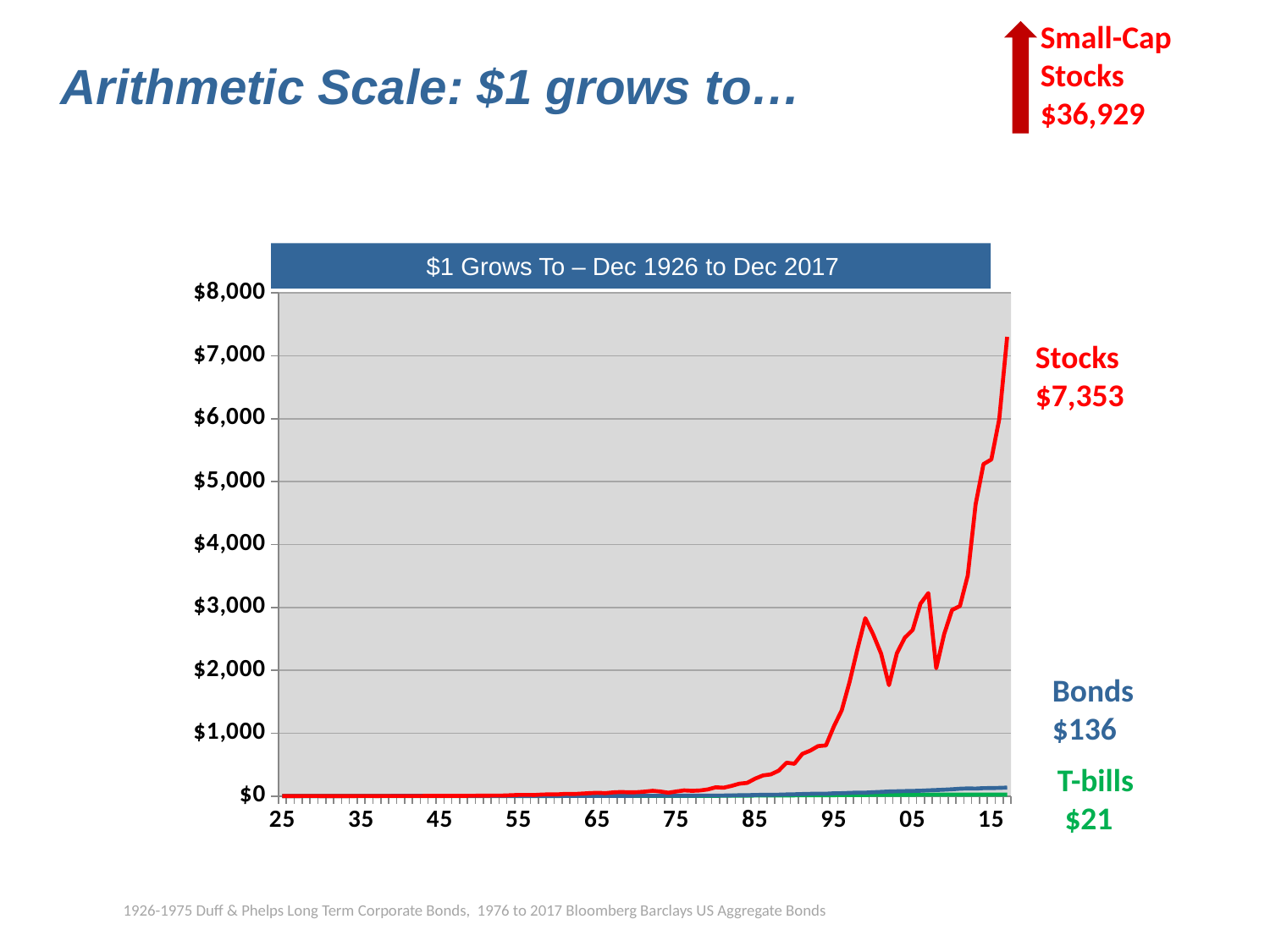
Which series ends with the lowest value on the chart? T-bills What is the difference between the final values of Stocks and Bonds? $7,217 Which series ends with the highest value on the chart? Stocks Which ends higher on the chart, Bonds or T-bills? Bonds What is the final value shown for Bonds on the chart? $136 Does the Stocks line generally rise or fall from left to right across the chart? Rise Is the final value of the Stocks line greater or less than $7,000? greater What is the difference between the final values of Bonds and T-bills? $115 What is the title of the chart? $1 Grows To – Dec 1926 to Dec 2017 What is the final value shown for Stocks on the chart? $7,353 What kind of chart is shown on the slide? Line chart What is the final value shown for T-bills on the chart? $21